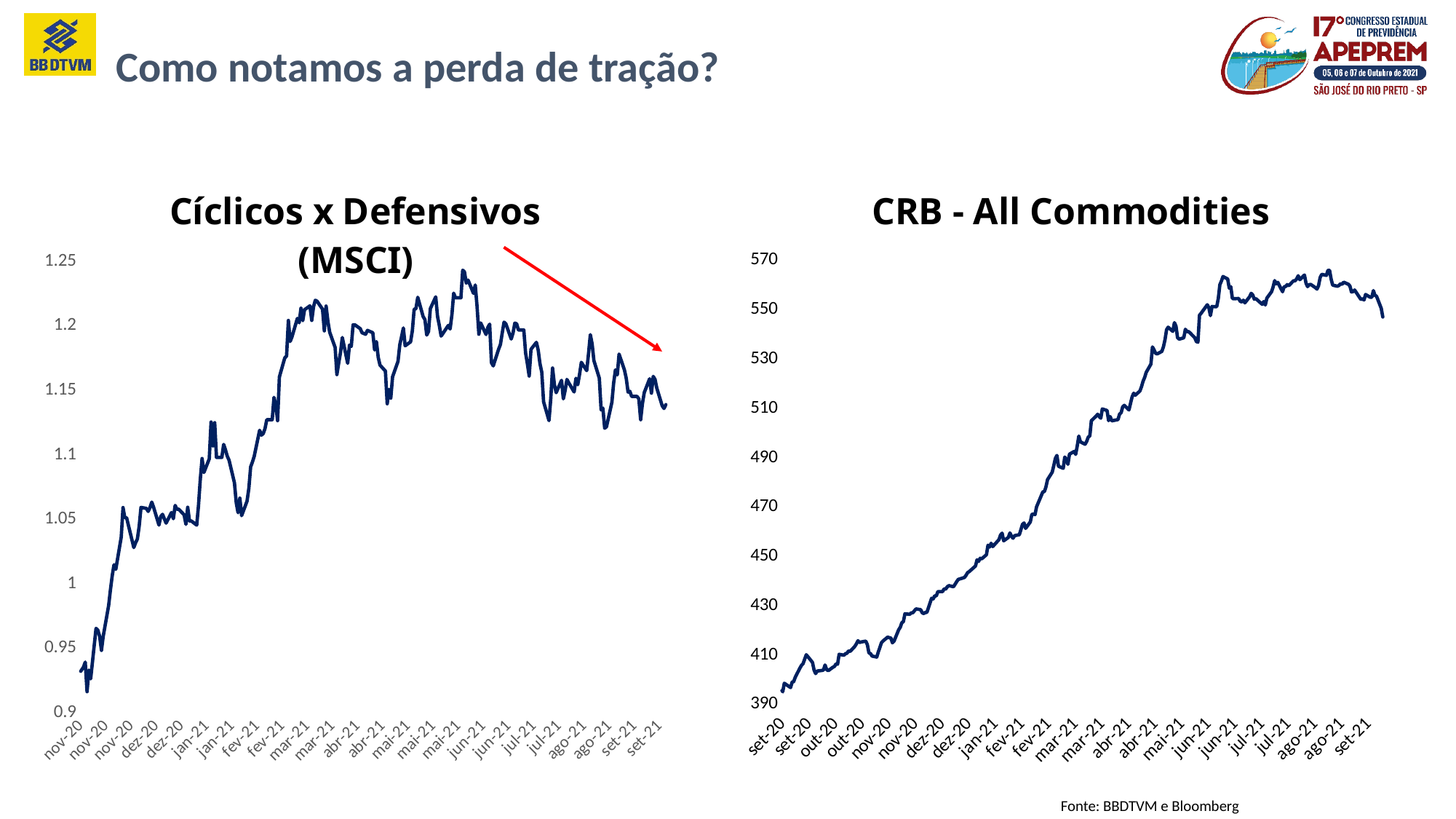
How many charts are shown on the slide? 2 What is the title of the chart on the left side of the slide? Cíclicos x Defensivos (MSCI) What is the title of the chart on the right side of the slide? CRB - All Commodities What kind of chart is the 'Cíclicos x Defensivos (MSCI)' chart? line chart In the 'Cíclicos x Defensivos (MSCI)' chart, is the value at the end of the series (set-21) greater or less than 1.1? greater In the 'CRB - All Commodities' chart, is the value at the end of the series (set-21) greater or less than 530? greater In the 'CRB - All Commodities' chart, is the value at the start of the series (set-20) greater or less than 410? less In the 'CRB - All Commodities' chart, do values overall rise or fall from set-20 to set-21? rise In the 'Cíclicos x Defensivos (MSCI)' chart, do values rise or fall from jun-21 to set-21? fall What kind of chart is the 'CRB - All Commodities' chart? line chart